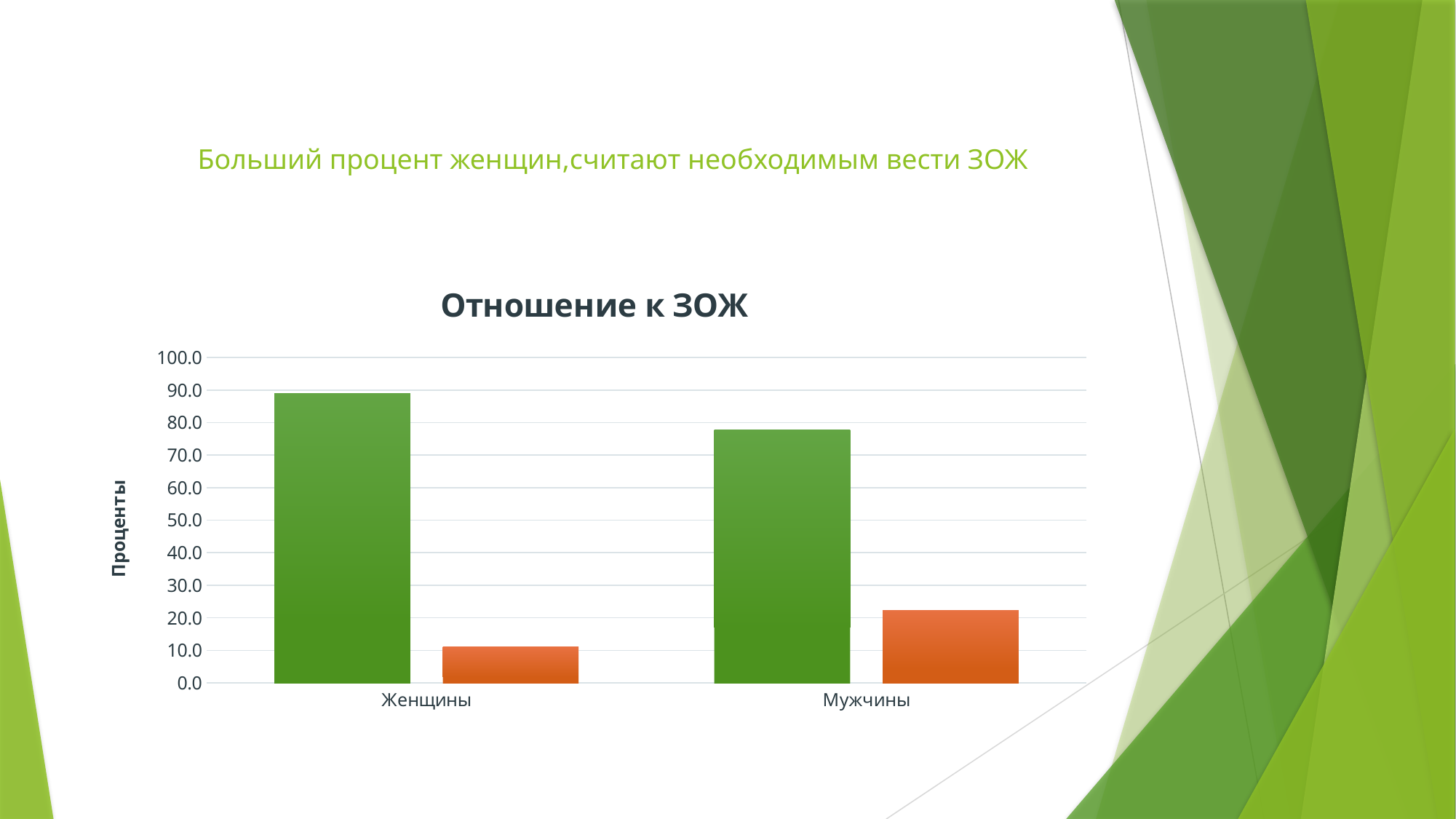
What kind of chart is shown on the slide? bar chart What is the title of the chart? Отношение к ЗОЖ Is the value of the green bar for Мужчины greater or less than 70? greater What is the label of the vertical axis of the chart? Проценты Is the value of the green bar for Женщины greater or less than 80? greater Which category has the taller orange bar, Женщины or Мужчины? Мужчины Which category has the highest green bar in the chart? Женщины Is the value of the orange bar for Женщины greater or less than 20? less How many categories are shown on the x axis of the chart? 2 Which category has the lowest orange bar in the chart? Женщины Which category has the taller green bar, Женщины or Мужчины? Женщины